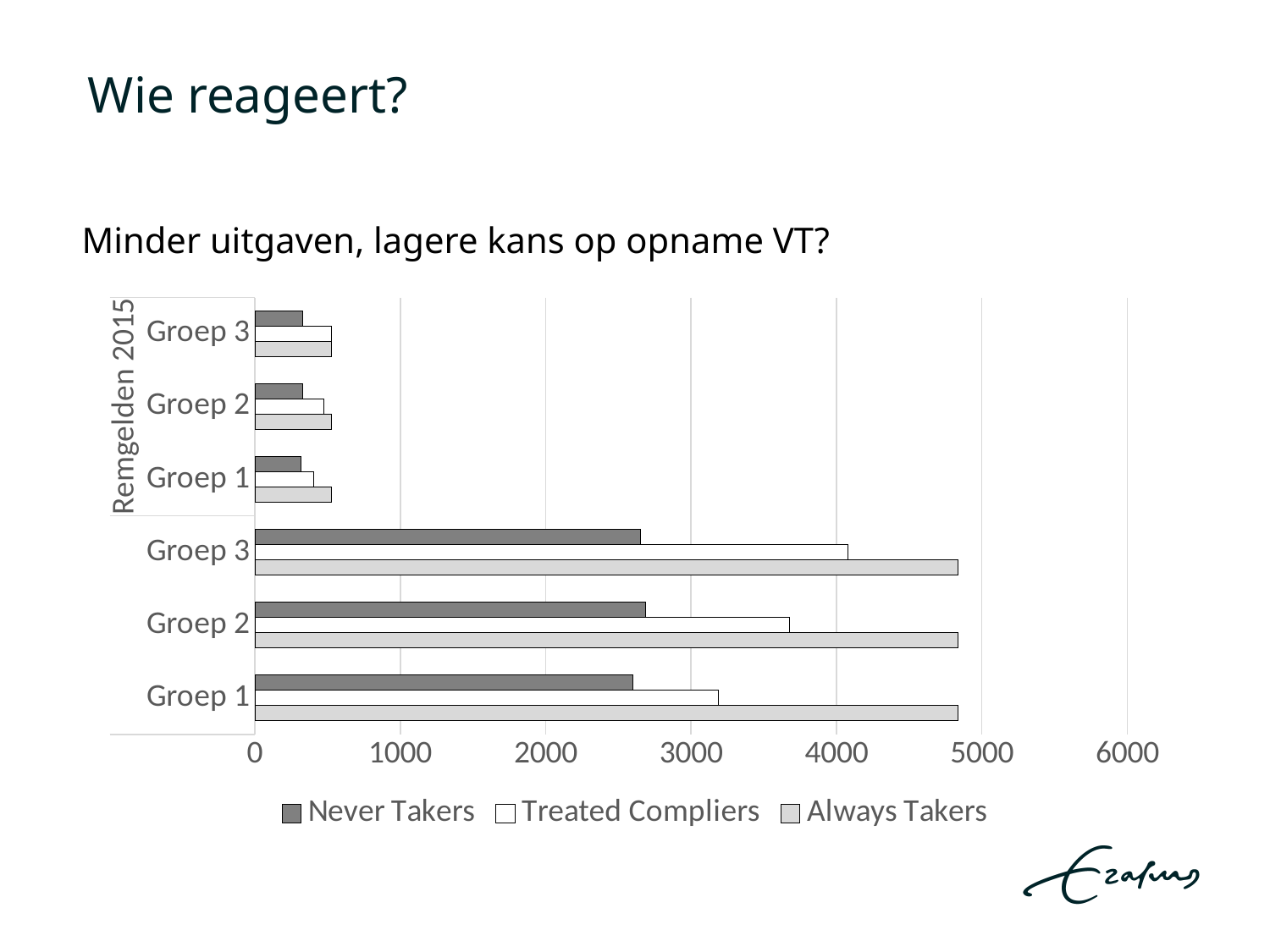
How many series does the legend list? 3 Is the Always Takers value for Groep 3 under Remgelden 2015 greater or less than 1000? less Is the Treated Compliers value for the lower Groep 3 (not under Remgelden 2015) greater or less than 3000? greater What kind of chart is shown on the slide? bar chart Is the Never Takers value for the lower Groep 1 (not under Remgelden 2015) greater or less than 3000? less For the lower Groep 1 (not under Remgelden 2015), which series has the highest value? Always Takers How many category labels are shown on the vertical axis of the chart? 6 Among the lower groups (not under Remgelden 2015), is the Treated Compliers value larger for Groep 1 or for Groep 2? Groep 2 Among the lower groups (not under Remgelden 2015), is the Treated Compliers value larger for Groep 3 or for Groep 2? Groep 3 For the lower Groep 1 (not under Remgelden 2015), which series has the lowest value? Never Takers What are the three series named in the legend? Never Takers, Treated Compliers, Always Takers